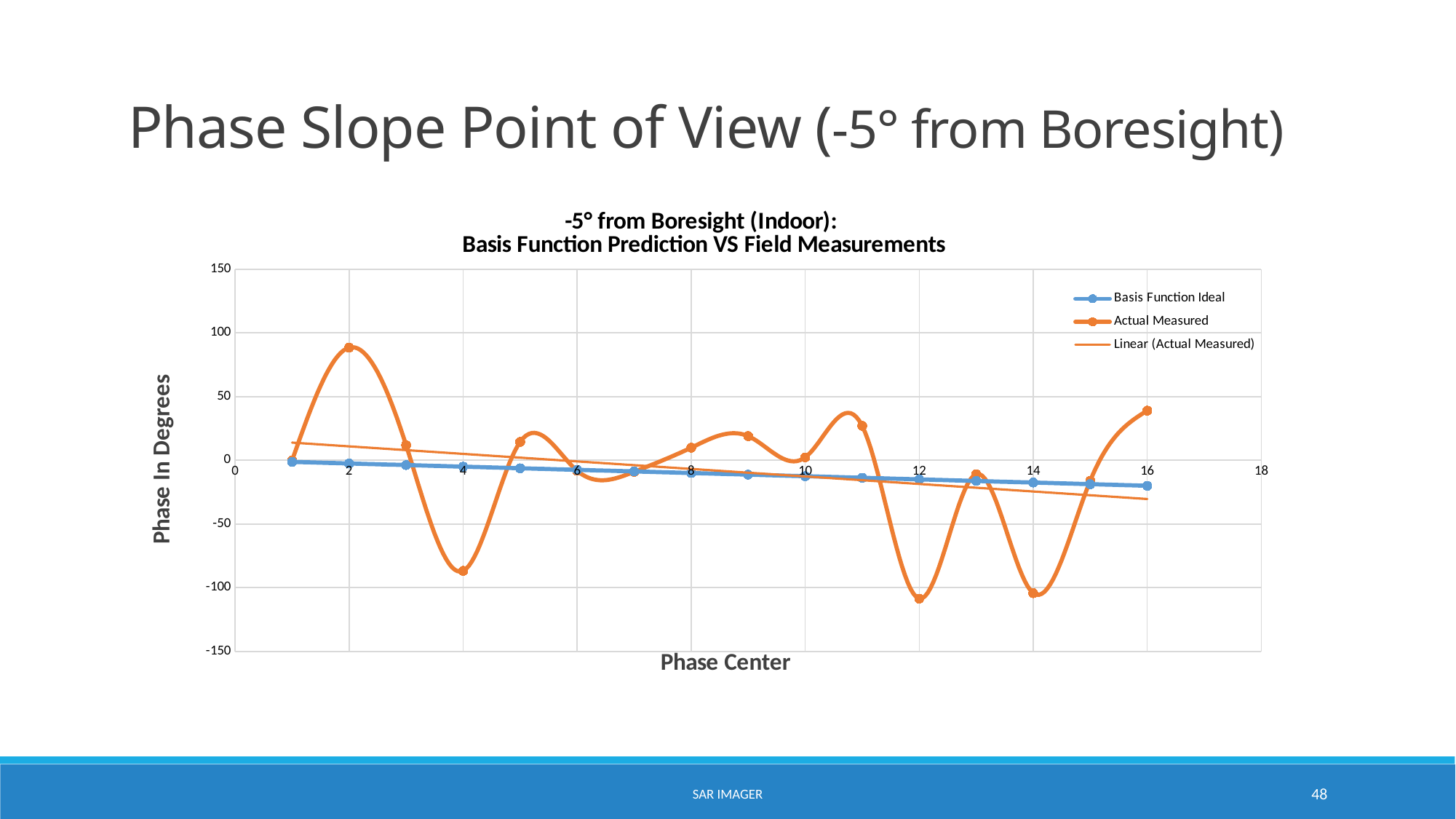
Is the Actual Measured value at Phase Center 2 greater or less than 50? greater At which Phase Center does the Actual Measured series reach its highest value? 2 At Phase Center 12, which series has the lower value, Basis Function Ideal or Actual Measured? Actual Measured How many entries does the chart legend list? 3 Is the Actual Measured value at Phase Center 4 greater or less than -50? less At Phase Center 2, which series has the higher value, Basis Function Ideal or Actual Measured? Actual Measured What is the label of the vertical axis? Phase In Degrees Is the Actual Measured value at Phase Center 16 greater or less than 0? greater What kind of chart is shown on the slide? Line chart Does the Basis Function Ideal series rise or fall as Phase Center increases? Fall How many data points does the Actual Measured series have? 16 What is the title of the chart? -5° from Boresight (Indoor): Basis Function Prediction VS Field Measurements